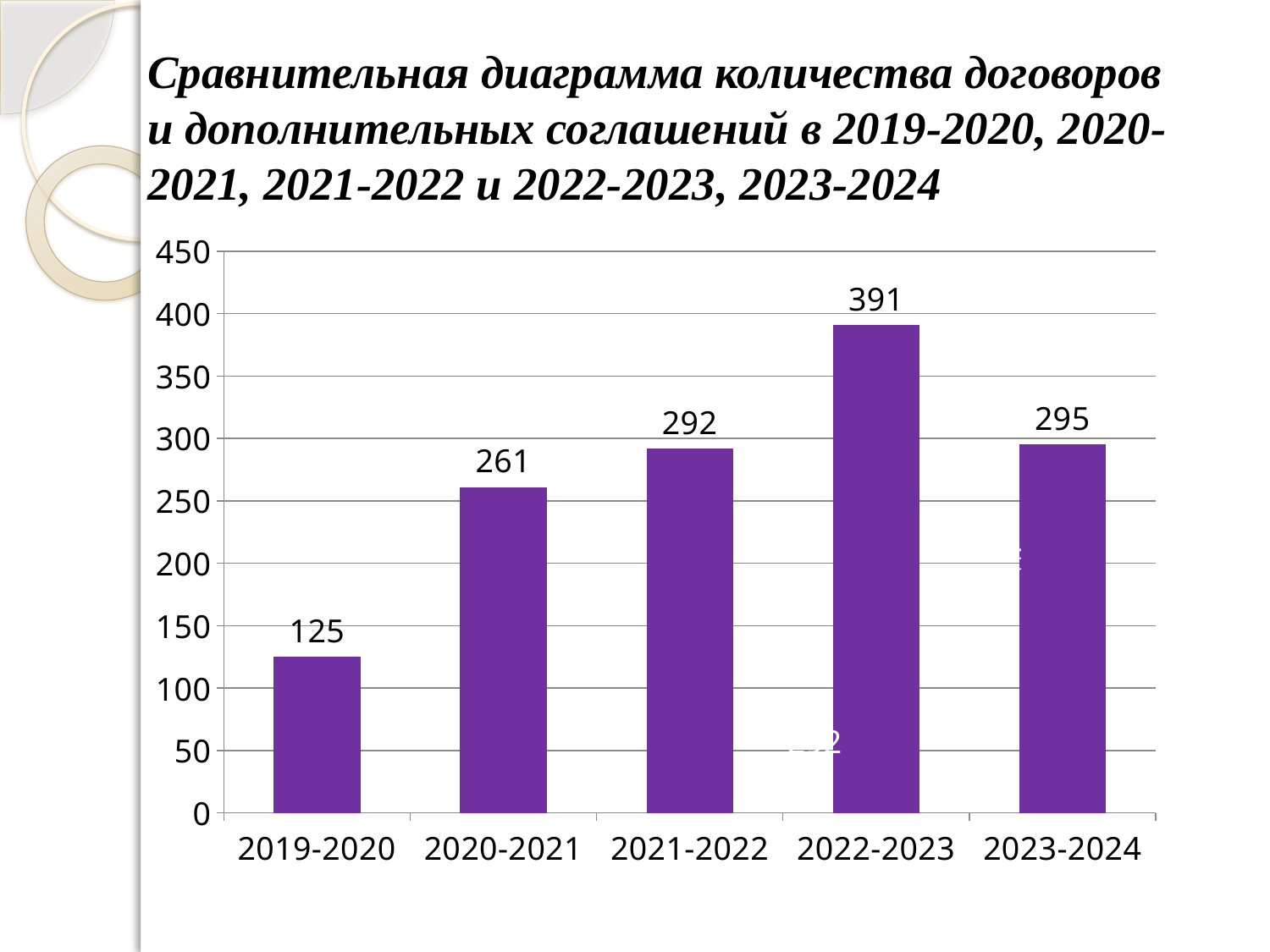
What is the difference between the values for 2020-2021 and 2019-2020? 136 Which period has the lowest value? 2019-2020 How many periods are shown on the x axis? 5 What is the value for 2022-2023? 391 Is the value for 2021-2022 greater or less than 250? greater What is the difference between the values for 2022-2023 and 2021-2022? 99 What kind of chart is shown on the slide? bar chart Which is larger, the value for 2020-2021 or the value for 2023-2024? 2023-2024 What is the value for 2019-2020? 125 Do the values rise or fall from 2019-2020 to 2022-2023? rise Which period has the highest value? 2022-2023 What is the value for 2023-2024? 295